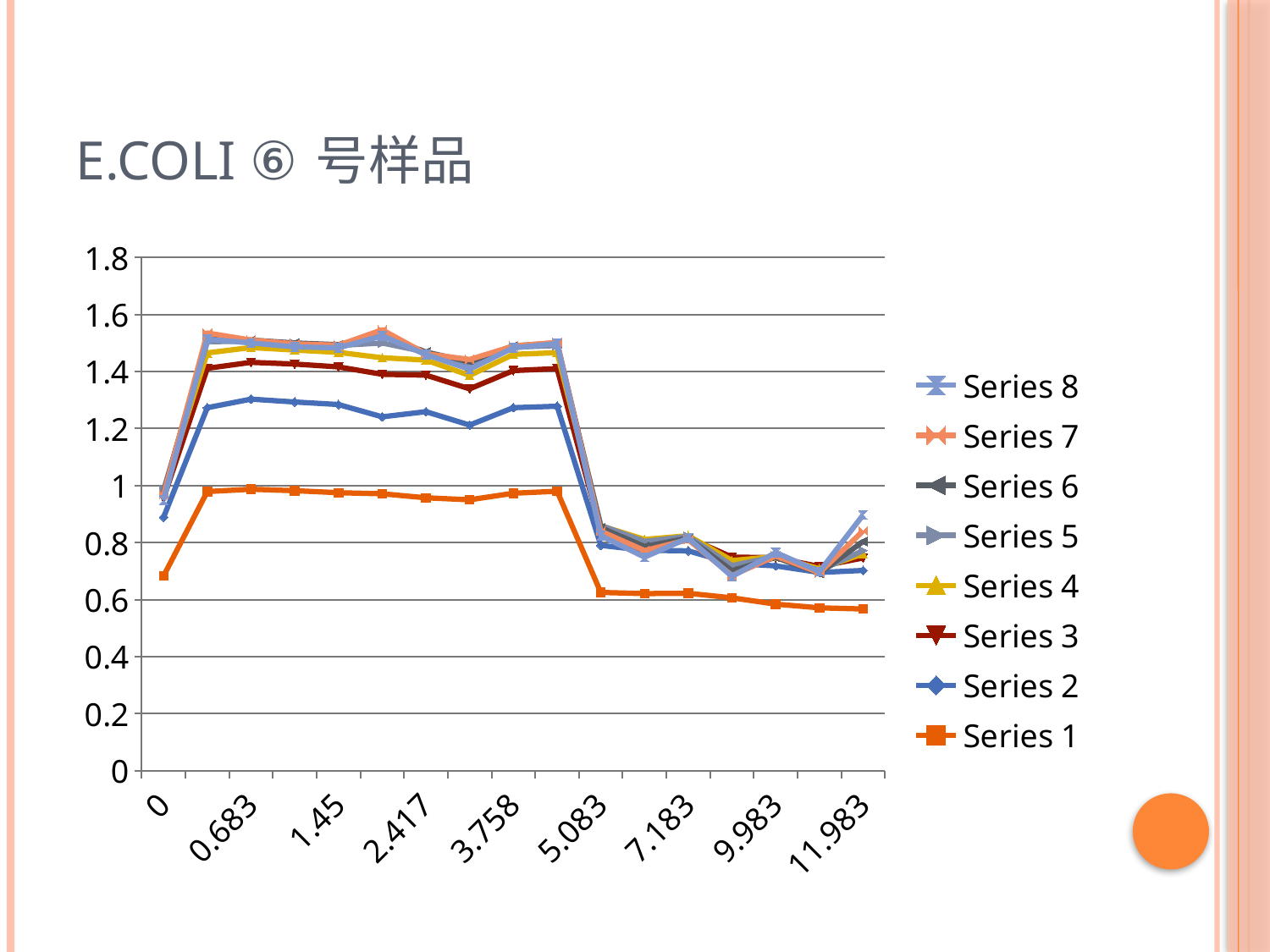
Which series is listed first (at the top) in the legend? Series 8 Is the value for Series 1 at x = 0 greater or less than 0.8? less What is the title of the slide containing the chart? E.COLI ⑥ 号样品 Which series is the lowest across the whole chart? Series 1 Which series has the lowest value at x = 0.683? Series 1 How many series does the legend list? 8 Is the value for Series 8 at x = 0.683 greater or less than 1.4? greater Is the value for Series 2 at x = 0.683 greater or less than 1.2? greater At x = 0.683, which is larger: Series 2 or Series 1? Series 2 What kind of chart is shown on the slide? line chart Does Series 1 rise or fall from x = 5.083 to x = 11.983? fall